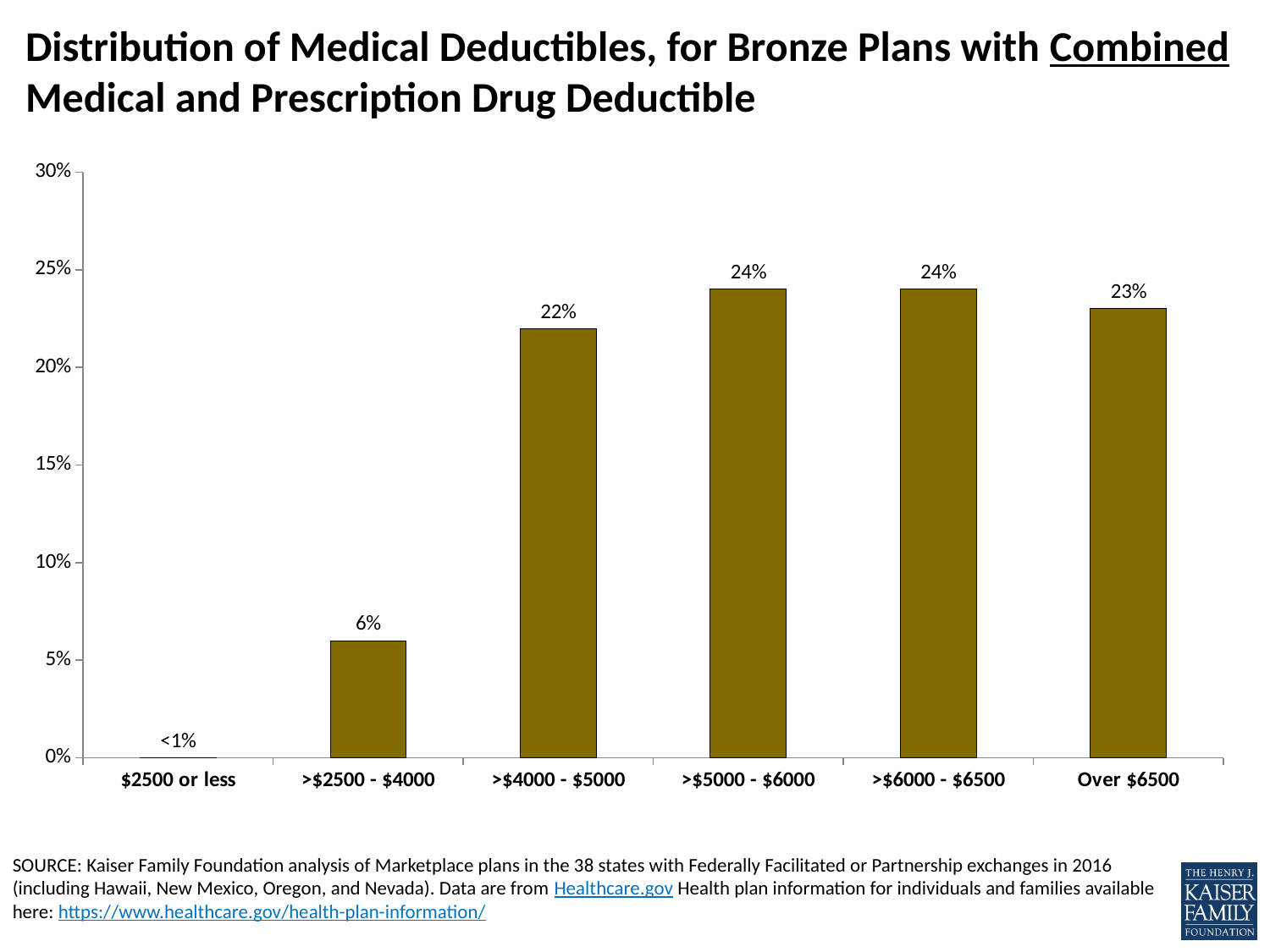
What is the highest value shown on the y axis? 30% What is the value for the "Over $6500" category? 23% What is the difference between the values for "Over $6500" and ">$4000 - $5000"? 1% What kind of chart is shown on the slide? bar chart What is the difference between the values for ">$5000 - $6000" and ">$2500 - $4000"? 18% How many categories are shown on the x axis? 6 What is the value for the ">$4000 - $5000" category? 22% What is the value for the ">$2500 - $4000" category? 6% What label is shown for the "$2500 or less" category? <1% Which is larger, the value for ">$4000 - $5000" or the value for ">$2500 - $4000"? >$4000 - $5000 Which category has the lowest value? $2500 or less Is the value for ">$6000 - $6500" greater or less than 20%? greater